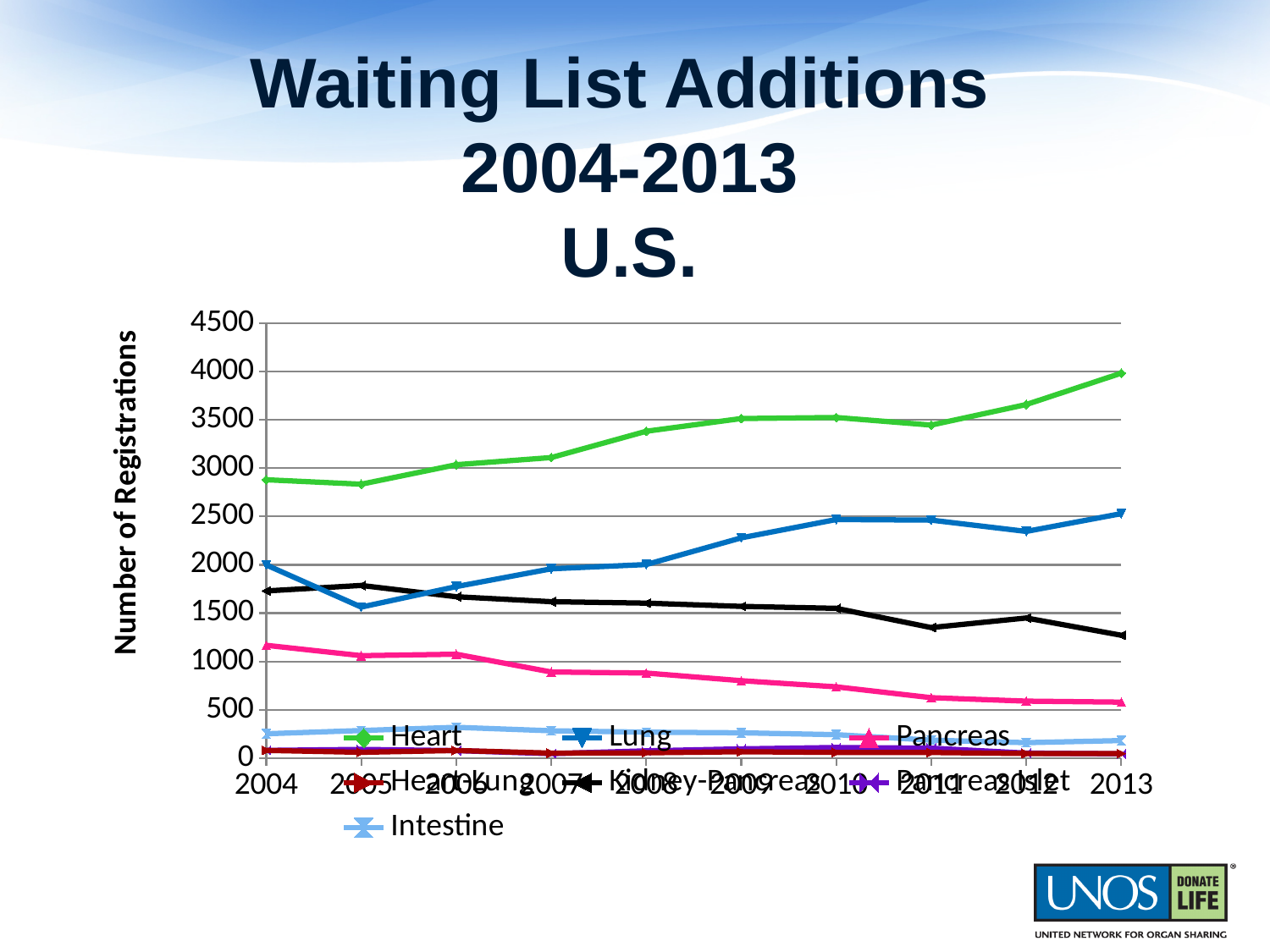
How many series does the legend list? 7 Is the value for Kidney-Pancreas in 2013 greater or less than 1500? less What kind of chart is shown on the slide? line chart Is the value for Heart in 2013 greater or less than 3500? greater In 2005, which is larger: Lung or Kidney-Pancreas? Kidney-Pancreas Is the value for Lung in 2005 greater or less than 2000? less What is the title of the chart? Waiting List Additions 2004-2013 U.S. Which series has the highest number of registrations in 2013? Heart Does the Pancreas series rise or fall from 2004 to 2013? fall How many years are plotted along the x axis? 10